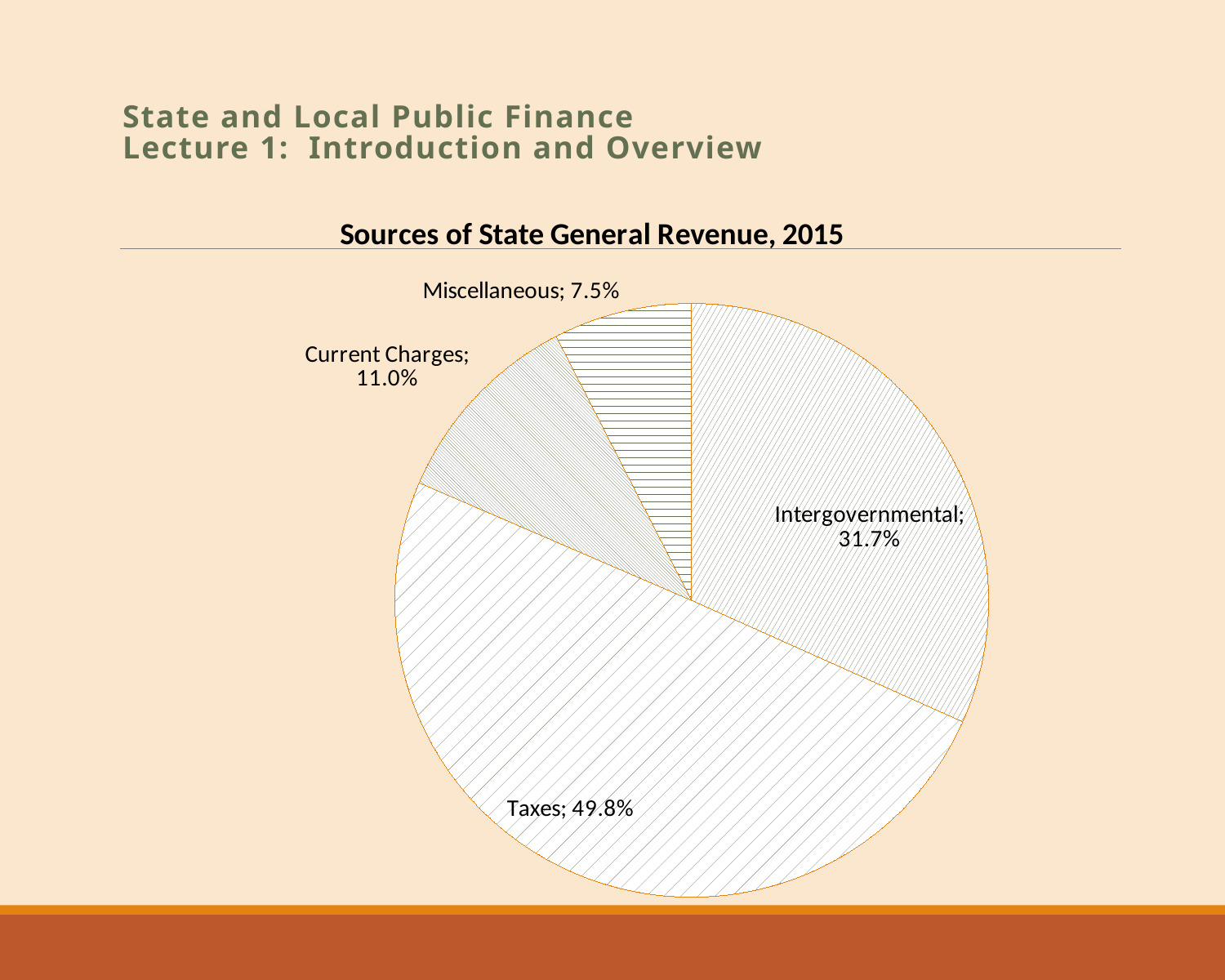
Which source accounts for the smallest share of state general revenue? Miscellaneous What share of state general revenue comes from Miscellaneous sources? 7.5% What type of chart is shown on the slide? pie chart What share of state general revenue comes from Taxes? 49.8% What is the difference in percentage points between the Taxes share and the Intergovernmental share? 18.1 What share of state general revenue comes from Current Charges? 11.0% What is the combined share of Current Charges and Miscellaneous? 18.5% Which is larger, the share for Current Charges or the share for Miscellaneous? Current Charges Which source accounts for the largest share of state general revenue? Taxes What is the title of the chart? Sources of State General Revenue, 2015 What share of state general revenue comes from Intergovernmental sources? 31.7% How many slices does the pie chart have? 4